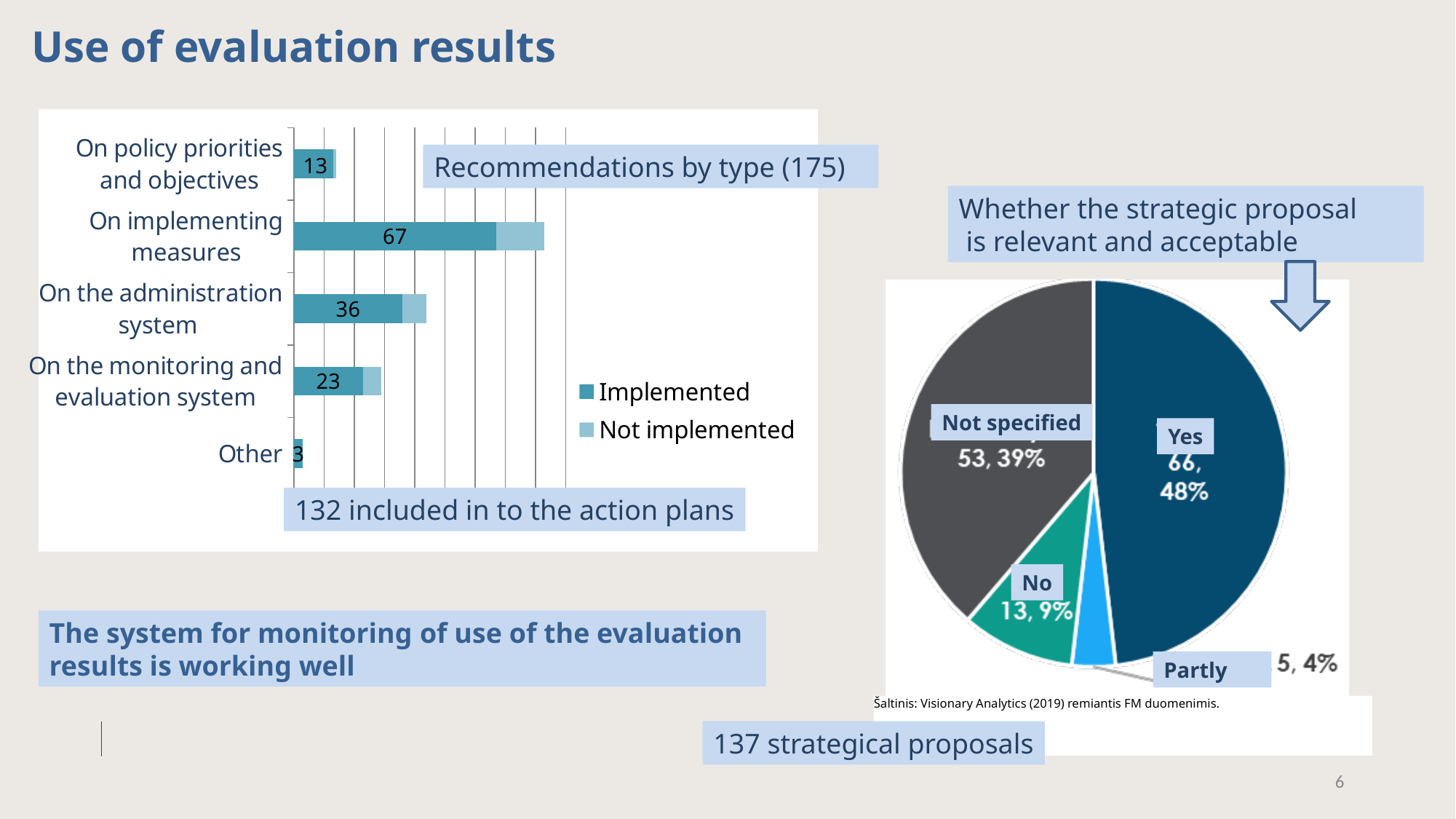
In the pie chart 'Whether the strategic proposal is relevant and acceptable', what share of proposals is 'Yes'? 48% How many slices does the pie chart 'Whether the strategic proposal is relevant and acceptable' have? 4 In the 'Recommendations by type (175)' chart, which category has the highest number of implemented recommendations? On implementing measures In the 'Recommendations by type (175)' chart, how many recommendations on the administration system were implemented? 36 In the 'Recommendations by type (175)' chart, which has more implemented recommendations: on policy priorities and objectives, or on the monitoring and evaluation system? On the monitoring and evaluation system In the pie chart 'Whether the strategic proposal is relevant and acceptable', which slice is the smallest? Partly In the 'Recommendations by type (175)' chart, how many recommendations on implementing measures were implemented? 67 In the 'Recommendations by type (175)' chart, what is the difference between the implemented recommendations on implementing measures and on the administration system? 31 What type of chart is 'Recommendations by type (175)'? Bar chart In the 'Recommendations by type (175)' chart, which category has the lowest number of implemented recommendations? Other How many series does the legend of the 'Recommendations by type (175)' chart list? 2 In the pie chart 'Whether the strategic proposal is relevant and acceptable', how many proposals are 'Not specified'? 53